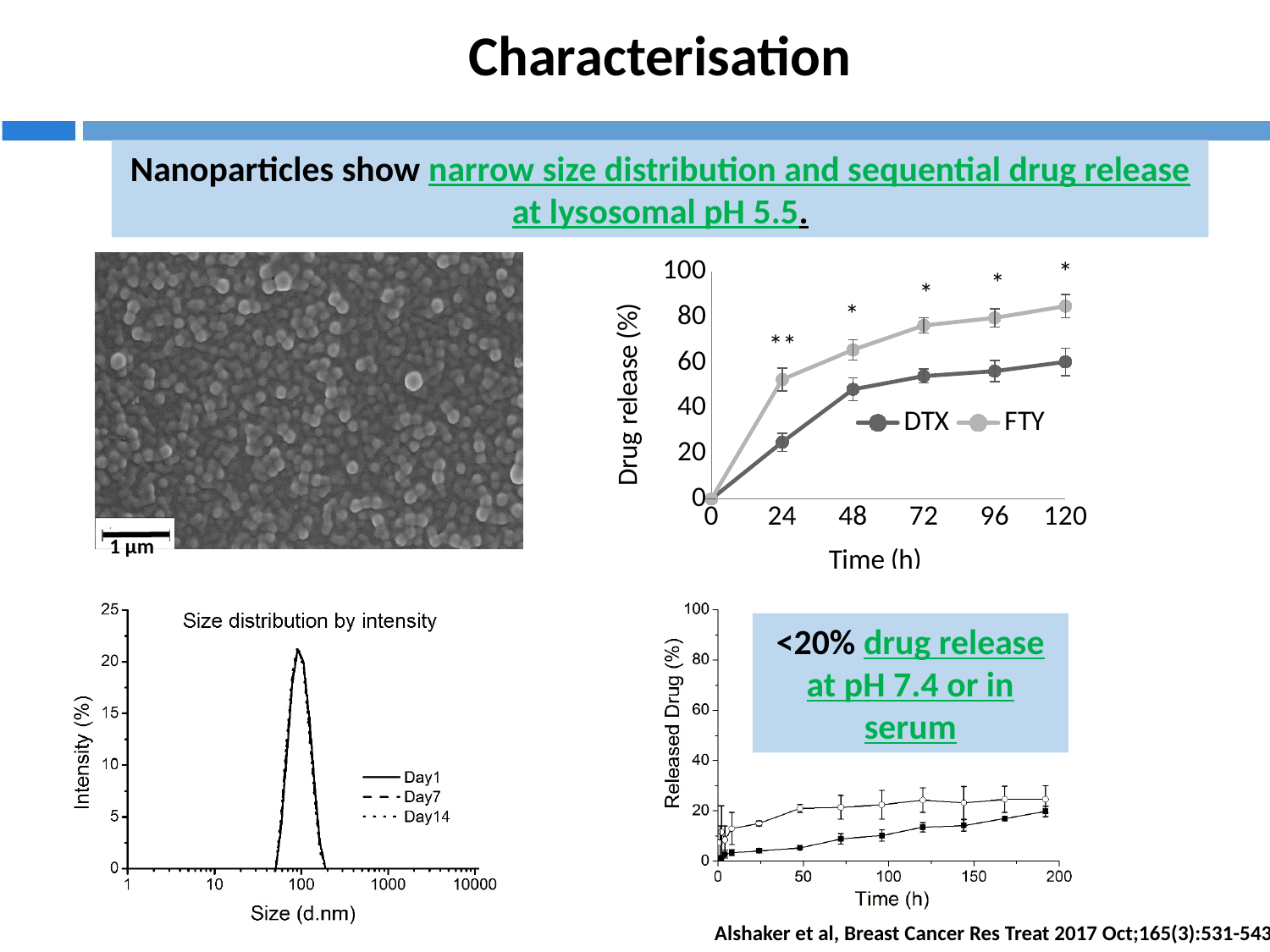
In the top-right drug release chart, which series shows the higher drug release at 120 h, DTX or FTY? FTY What kind of chart is the top-right drug release chart? line chart In the top-right drug release chart, is the value for FTY at 24 h greater or less than 40? greater In the bottom-right 'Released Drug (%)' chart, are the values of both series at 200 h greater or less than 40? less In the top-right drug release chart, do the DTX values rise or fall as time increases from 0 to 120 h? rise How many series does the legend of the bottom-left 'Size distribution by intensity' chart list? 3 In the bottom-left 'Size distribution by intensity' chart, is the peak intensity greater or less than 20? greater What is the x-axis label of the bottom-left 'Size distribution by intensity' chart? Size (d.nm) How many series does the legend of the top-right drug release chart list? 2